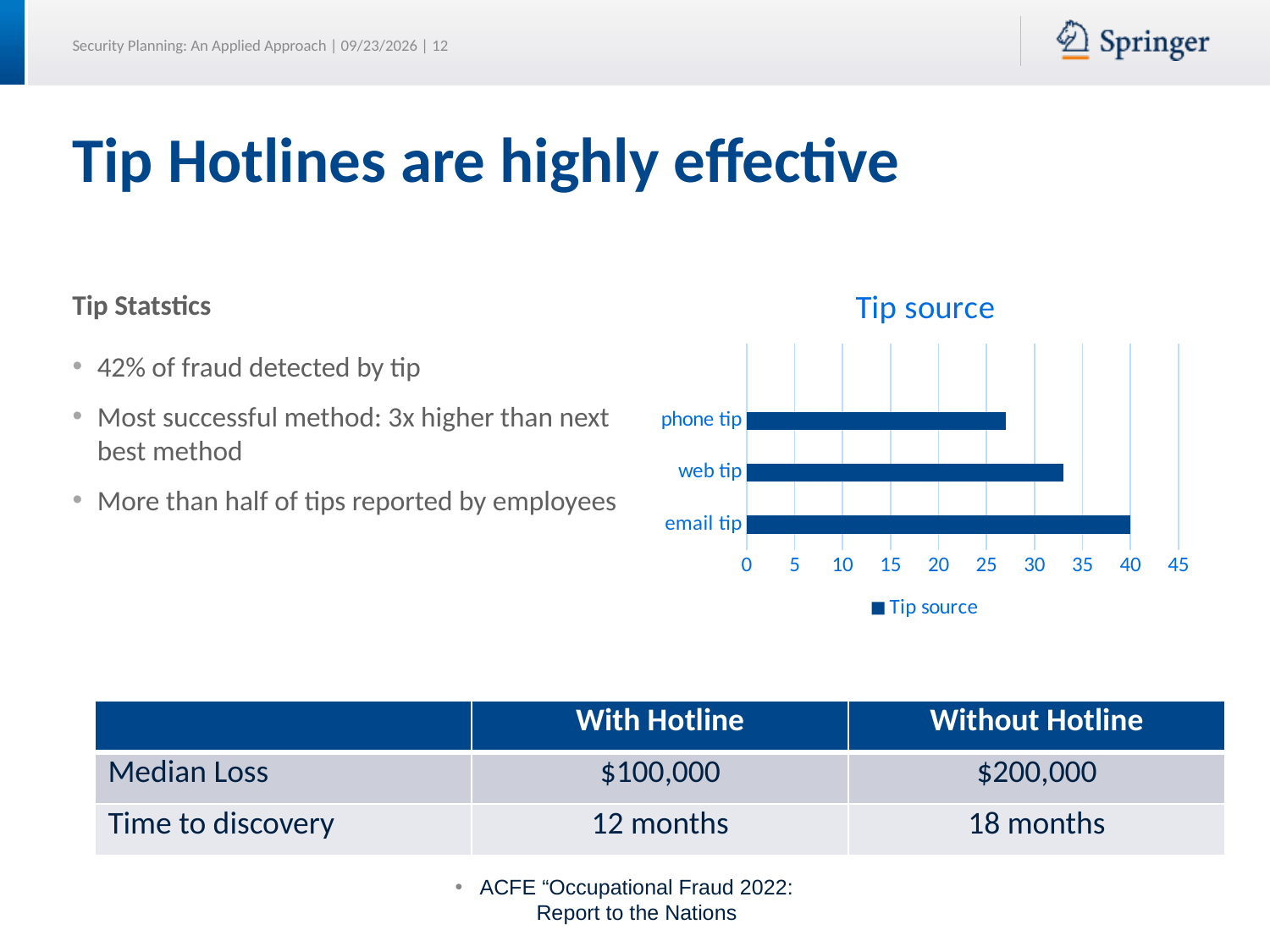
Which tip source has the highest value in the chart? email tip Is the value for web tip greater or less than 30? greater What is the highest value shown on the x axis of the Tip source chart? 45 What is the title of the chart on the slide? Tip source Which tip source has the lowest value in the chart? phone tip Is the value for phone tip greater or less than 30? less Is the value for email tip greater or less than 35? greater How many categories are plotted in the Tip source chart? 3 How many series does the legend of the Tip source chart list? 1 Which is larger in the Tip source chart, web tip or phone tip? web tip What kind of chart is shown on the slide? bar chart